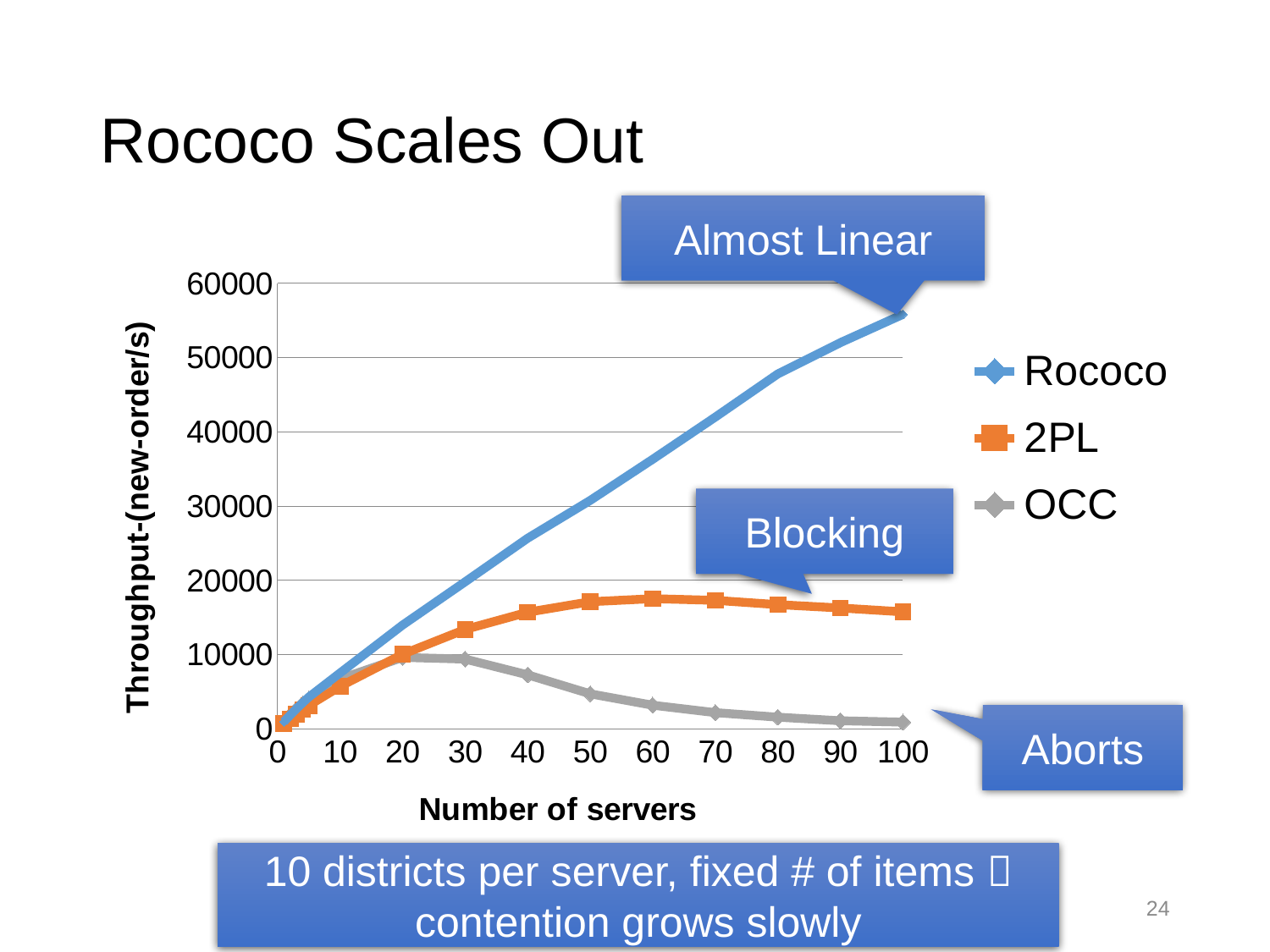
Does the Rococo throughput rise or fall as the number of servers increases? rises Is the throughput for Rococo at 100 servers greater or less than 50000? greater How many series does the legend list? 3 Is the throughput for Rococo at 60 servers greater or less than 30000? greater What is the label of the x axis? Number of servers Does the OCC throughput rise or fall as the number of servers increases from 30 to 100? falls Is the throughput for OCC at 100 servers greater or less than 10000? less Which series has the highest throughput at 100 servers? Rococo What kind of chart is shown on the slide? line chart Which series has the lowest throughput at 100 servers? OCC At 100 servers, which has higher throughput, Rococo or 2PL? Rococo